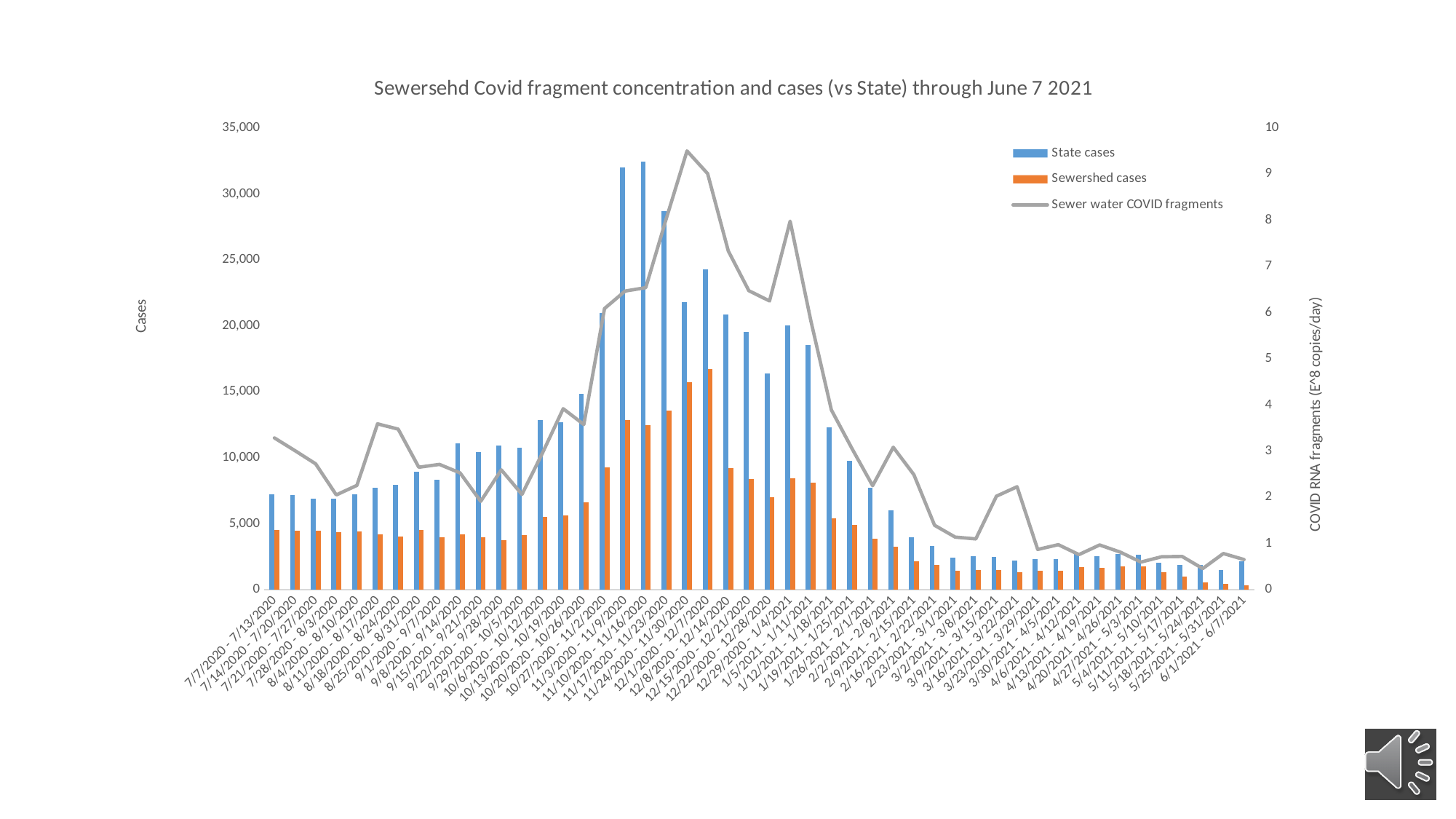
Is the value for Sewer water COVID fragments in 11/24/2020 - 11/30/2020 greater or less than 9? greater Is the value for State cases in 11/3/2020 - 11/9/2020 greater or less than 30,000? greater Do State cases rise or fall from 12/1/2020 - 12/7/2020 to 6/1/2021 - 6/7/2021? fall In which period do Sewershed cases reach their highest value? 12/1/2020 - 12/7/2020 What is the title of the right-hand vertical axis? COVID RNA fragments (E^8 copies/day) Which period has more State cases, 11/3/2020 - 11/9/2020 or 12/1/2020 - 12/7/2020? 11/3/2020 - 11/9/2020 How many series does the legend list? 3 In which period does the Sewer water COVID fragments line reach its peak? 11/24/2020 - 11/30/2020 What is the title of the chart? Sewersehd Covid fragment concentration and cases (vs State) through June 7 2021 Is the value for Sewershed cases in 12/1/2020 - 12/7/2020 greater or less than 15,000? greater How many weekly periods are shown on the x axis? 48